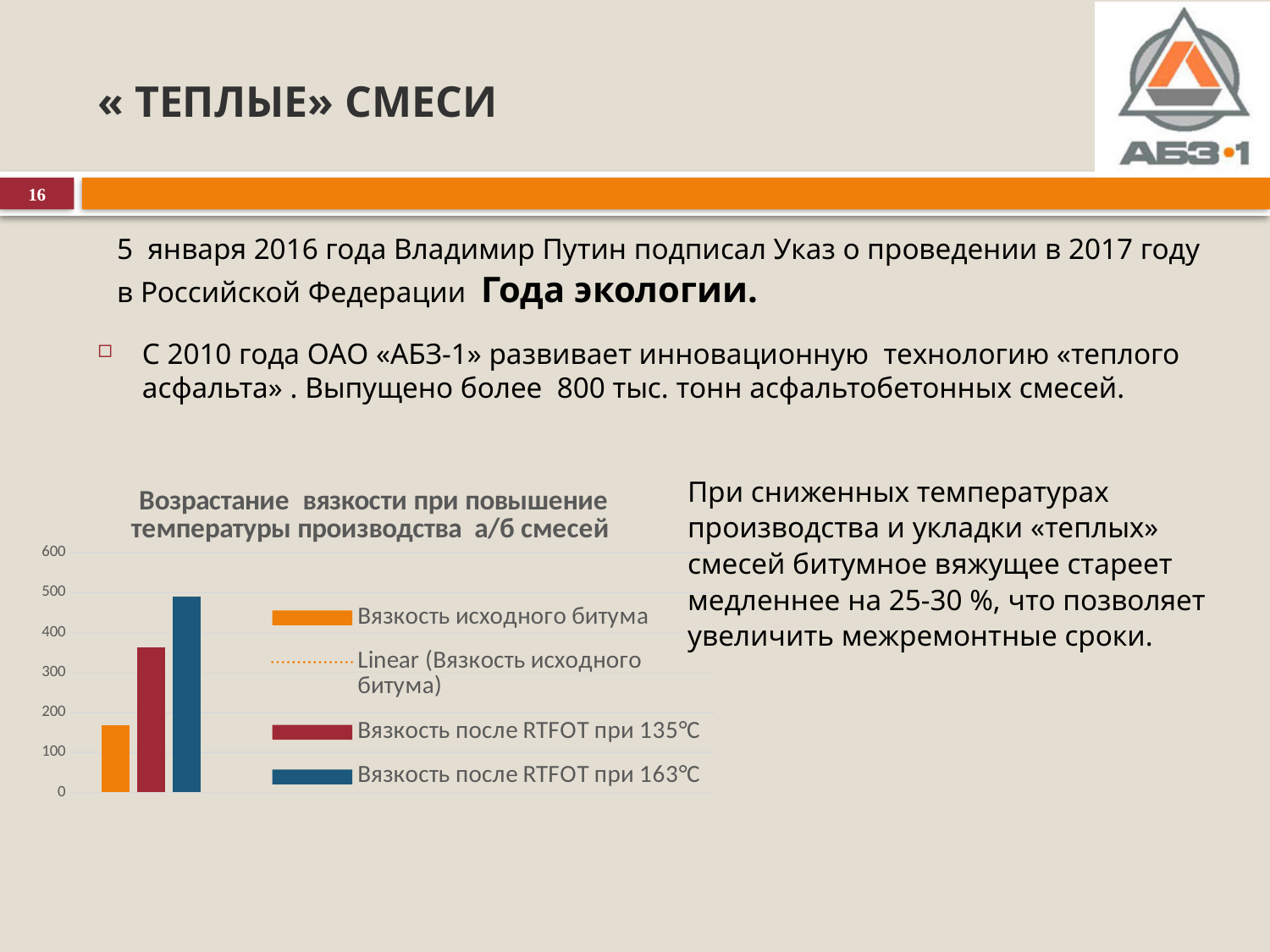
How many bars are plotted in the chart? 3 Do the bars rise or fall from left to right across the chart? rise What kind of chart is shown on the slide? bar chart What is the title of the chart? Возрастание вязкости при повышение температуры производства а/б смесей Which is larger: the bar for Вязкость после RTFOT при 135℃ or the bar for Вязкость исходного битума? Вязкость после RTFOT при 135℃ What colour is the bar for Вязкость после RTFOT при 163℃? blue Which series has the highest bar in the chart? Вязкость после RTFOT при 163℃ Which series has the lowest bar in the chart? Вязкость исходного битума Is the value for Вязкость после RTFOT при 135℃ greater or less than 300? greater Is the value for Вязкость исходного битума greater or less than 200? less How many entries does the chart legend list? 4 Is the value for Вязкость после RTFOT при 163℃ greater or less than 400? greater